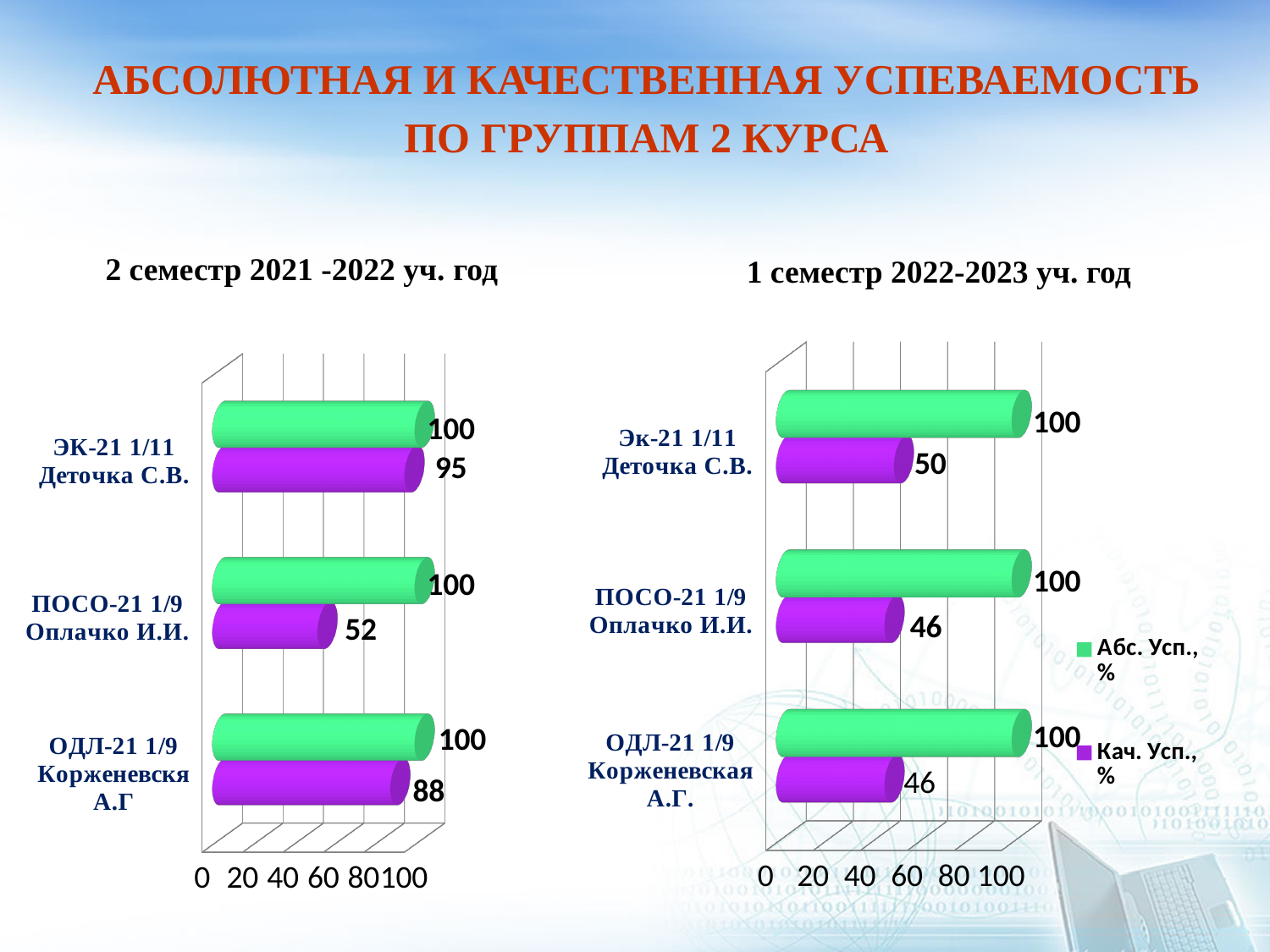
How many groups are shown in the chart titled "1 семестр 2022-2023 уч. год"? 3 What type of chart is the chart titled "2 семестр 2021 -2022 уч. год"? Bar chart In the chart titled "2 семестр 2021 -2022 уч. год", which group has the lowest Кач. Усп., % value? ПОСО-21 1/9 Оплачко И.И. In the chart titled "1 семестр 2022-2023 уч. год", which group has the highest Кач. Усп., % value? Эк-21 1/11 Деточка С.В. In the chart titled "1 семестр 2022-2023 уч. год", what is the difference between the Абс. Усп., % and Кач. Усп., % values for ПОСО-21 1/9 Оплачко И.И.? 54 In the chart titled "2 семестр 2021 -2022 уч. год", what is the difference between the Абс. Усп., % and Кач. Усп., % values for ОДЛ-21 1/9 Корженевска А.Г? 12 In the chart titled "1 семестр 2022-2023 уч. год", what is the Кач. Усп., % value for Эк-21 1/11 Деточка С.В.? 50 Which is larger: the Кач. Усп., % value for ЭК-21 1/11 Деточка С.В. in the "2 семестр 2021 -2022 уч. год" chart or in the "1 семестр 2022-2023 уч. год" chart? 2 семестр 2021 -2022 уч. год In the chart titled "2 семестр 2021 -2022 уч. год", what is the Кач. Усп., % value for ПОСО-21 1/9 Оплачко И.И.? 52 In the chart titled "2 семестр 2021 -2022 уч. год", what is the Абс. Усп., % value for ОДЛ-21 1/9 Корженевска А.Г? 100 In the chart titled "2 семестр 2021 -2022 уч. год", which group has the highest Кач. Усп., % value? ЭК-21 1/11 Деточка С.В. How many series does the legend of the chart titled "1 семестр 2022-2023 уч. год" list? 2